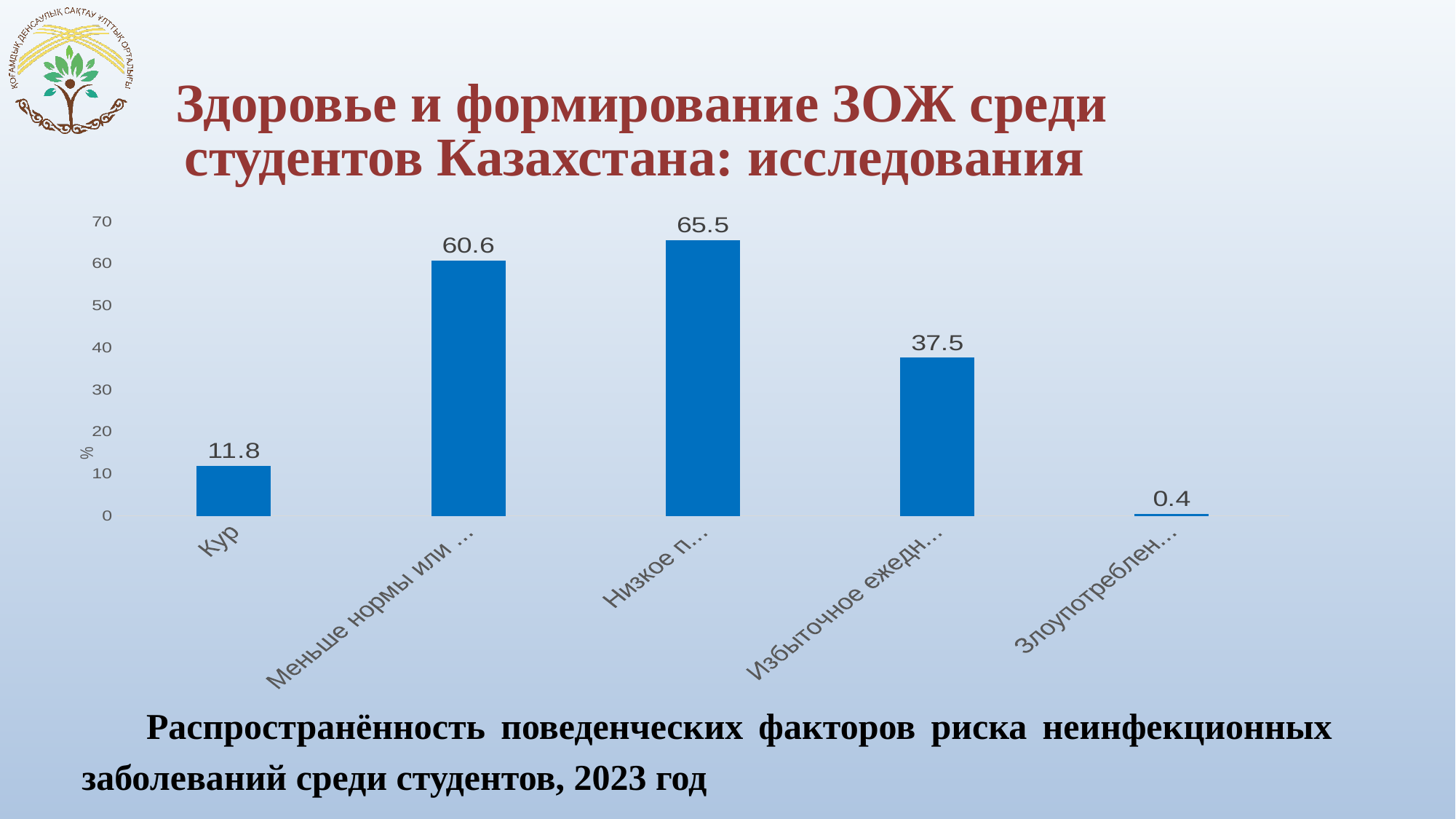
What is the value of the second bar, labelled "Меньше нормы или …"? 60.6 What is the value of the first bar, labelled "Кур"? 11.8 What kind of chart is shown on the slide? bar chart Which bar has the highest value? Низкое п… (third bar) Which bar has the lowest value? Злоупотреблен… (last bar) What is the difference between the values of the third bar (65.5) and the second bar (60.6)? 4.9 How many bars (categories) does the chart show? 5 What is the value of the third bar, labelled "Низкое п…"? 65.5 What unit is shown on the vertical axis label? % What is the value of the fourth bar, labelled "Избыточное ежедн…"? 37.5 Which is larger: the value for "Кур" or the value for "Избыточное ежедн…"? Избыточное ежедн… What is the value of the last bar, labelled "Злоупотреблен…"? 0.4